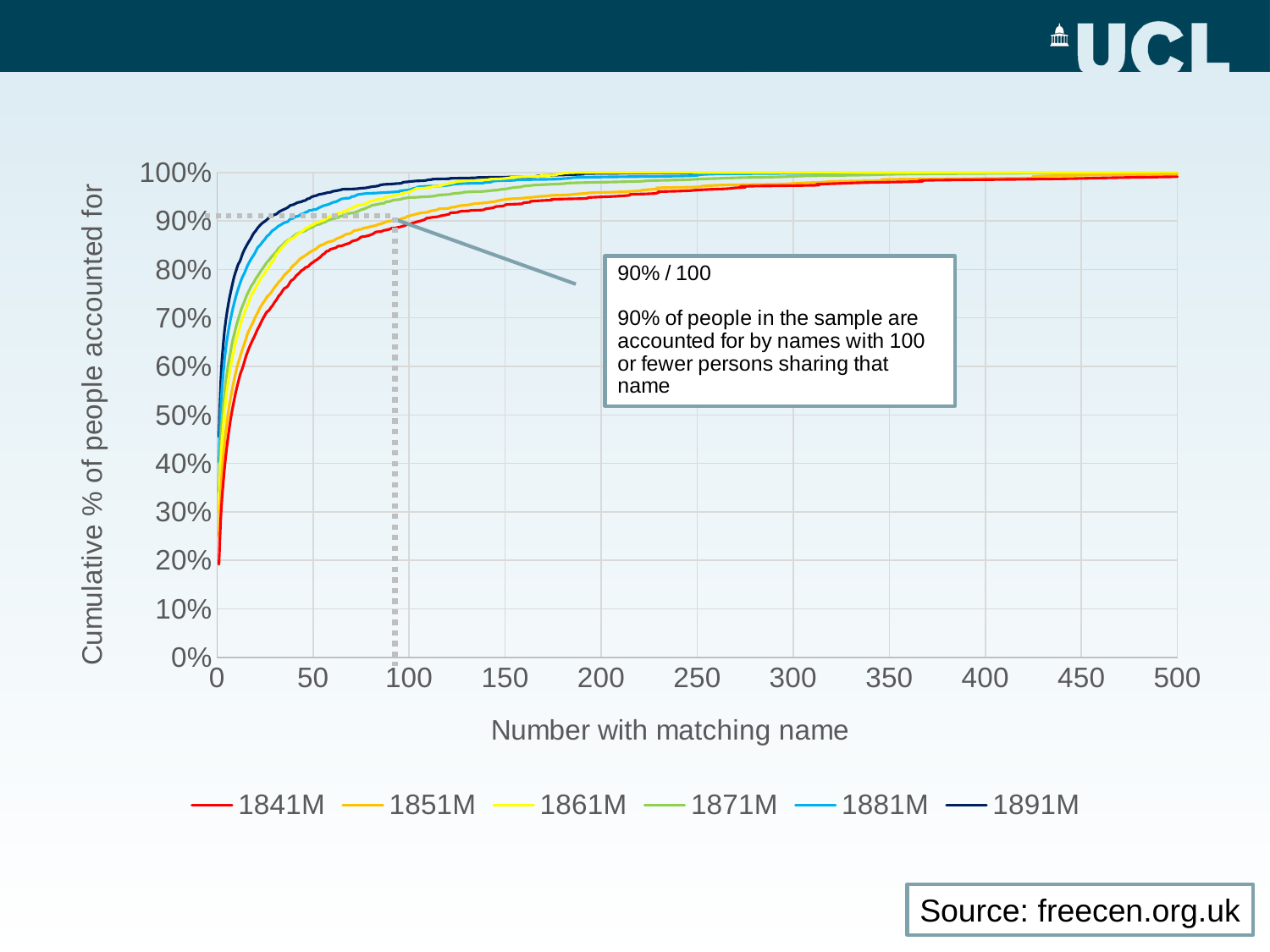
At a number with matching name of 10, is the value for 1841M greater or less than 70%? less At a number with matching name of 50, is the value for 1891M greater or less than 90%? greater According to the annotation box, what cumulative % is accounted for by names with 100 or fewer persons sharing that name? 90% What is the title of the y axis? Cumulative % of people accounted for Which series has the lowest cumulative % at a number with matching name of 50? 1841M How many series does the legend list? 6 Do the values of the 1841M series rise or fall as the number with matching name increases? Rise At a number with matching name of 100, which is larger: the value for 1881M or the value for 1851M? 1881M At a number with matching name of 50, is the value for 1841M greater or less than 70%? greater Which series has the highest cumulative % at a number with matching name of 50? 1891M What kind of chart is shown on the slide? Line chart What is the title of the x axis? Number with matching name